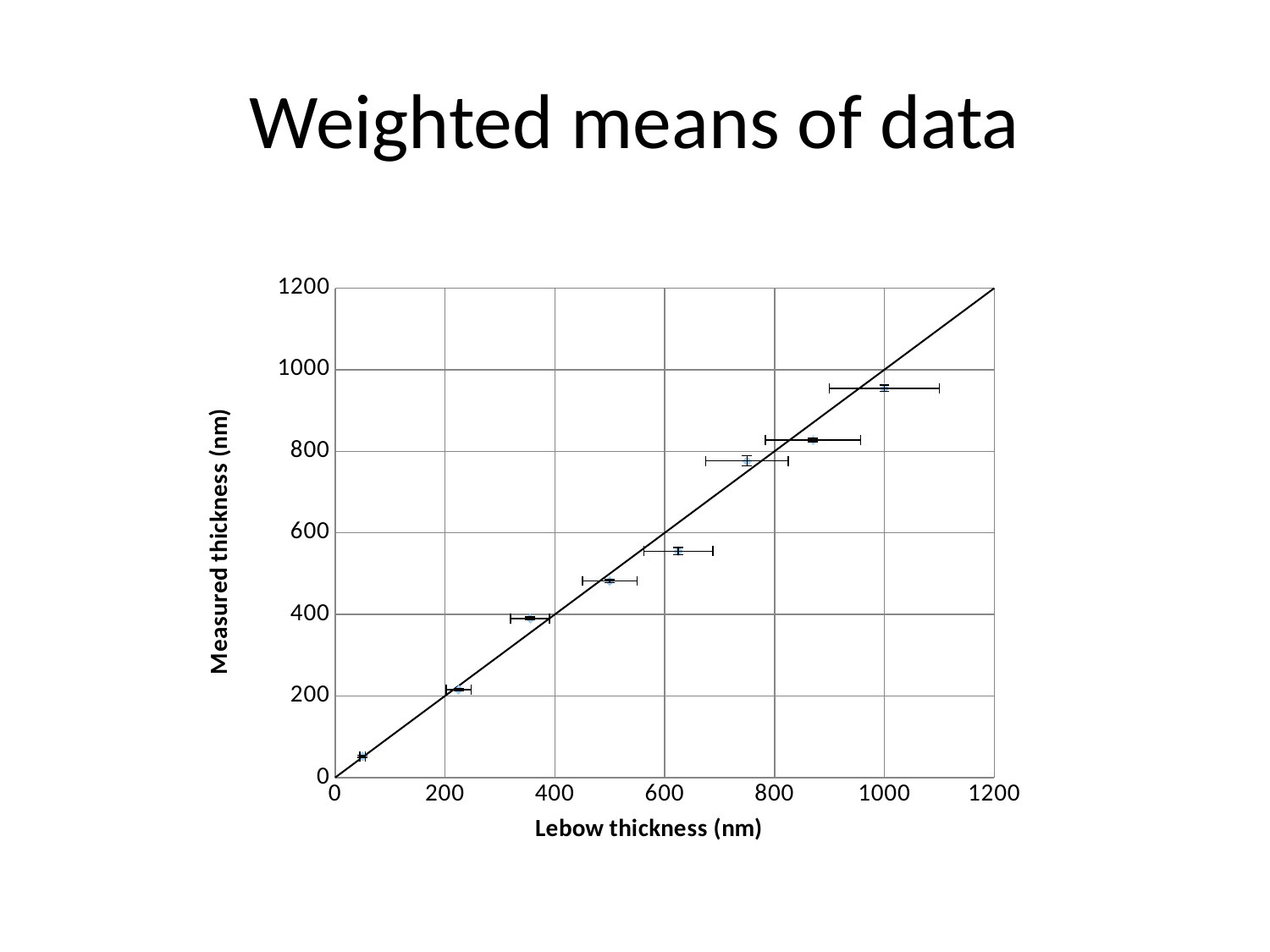
Which data point has the highest measured thickness: the one at a Lebow thickness of about 1000 nm or the one at about 50 nm? the one at about 1000 nm What is the label of the x axis? Lebow thickness (nm) What is the title of the chart? Weighted means of data Is the measured thickness for the data point at a Lebow thickness of about 220 nm greater or less than 200? greater What kind of chart is shown on the slide? scatter chart What is the maximum value shown on the y axis? 1200 Is the measured thickness for the data point at a Lebow thickness of about 1000 nm greater or less than 800? greater Is the measured thickness for the data point at a Lebow thickness of about 870 nm greater or less than 800? greater How many data points are plotted on the chart? 8 Do the measured thickness values rise or fall as Lebow thickness increases along the x axis? rise